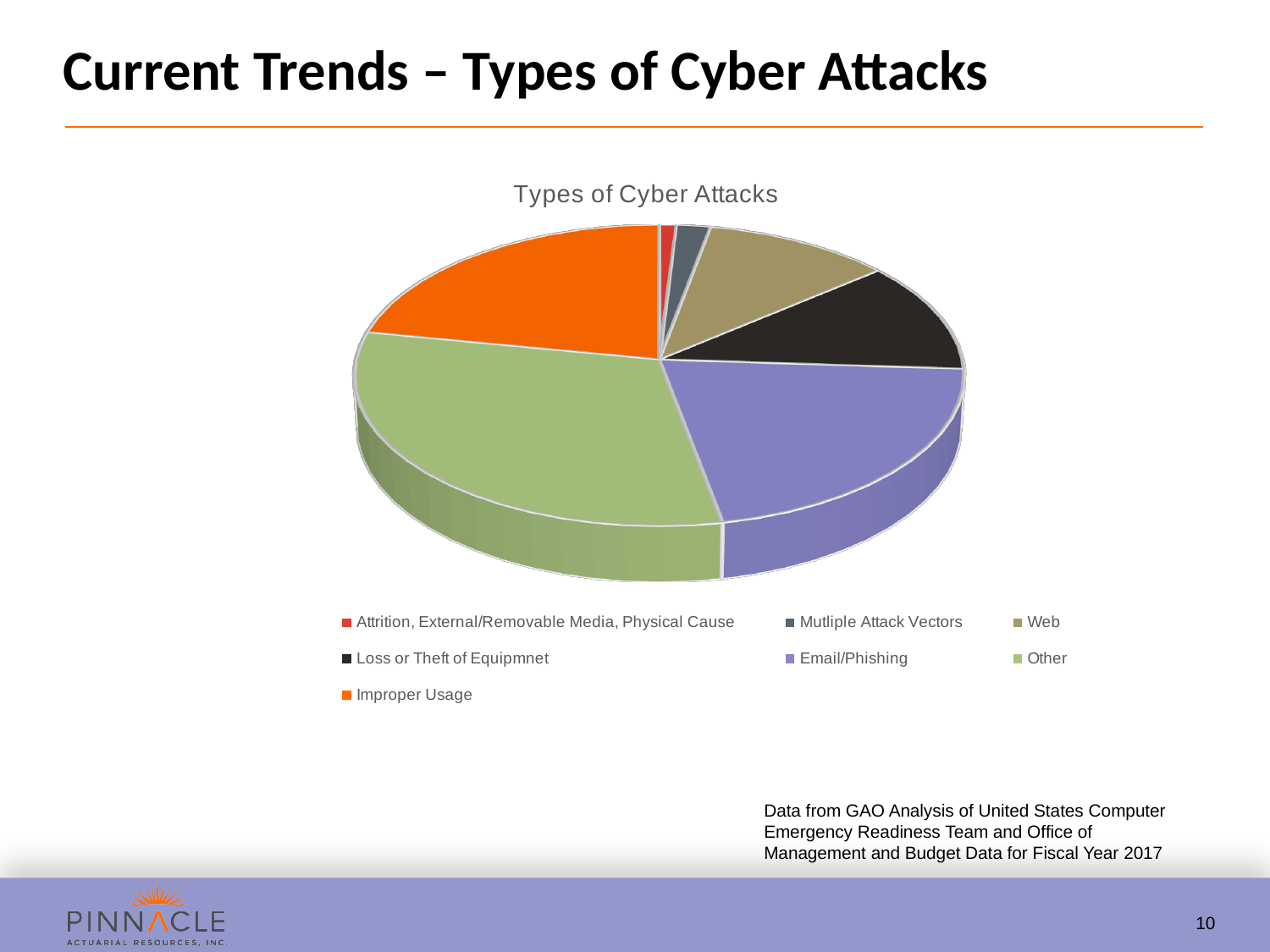
How many categories does the pie chart's legend list? 7 Which category has the largest slice of the pie? Other Which category has the smallest slice of the pie? Attrition, External/Removable Media, Physical Cause Which slice is larger, Other or Email/Phishing? Other What kind of chart is shown on the slide? Pie chart What colour is the Improper Usage slice? Orange Which slice is larger, Improper Usage or Web? Improper Usage Which slice is larger, Loss or Theft of Equipmnet or Mutliple Attack Vectors? Loss or Theft of Equipmnet What is the title of the chart? Types of Cyber Attacks